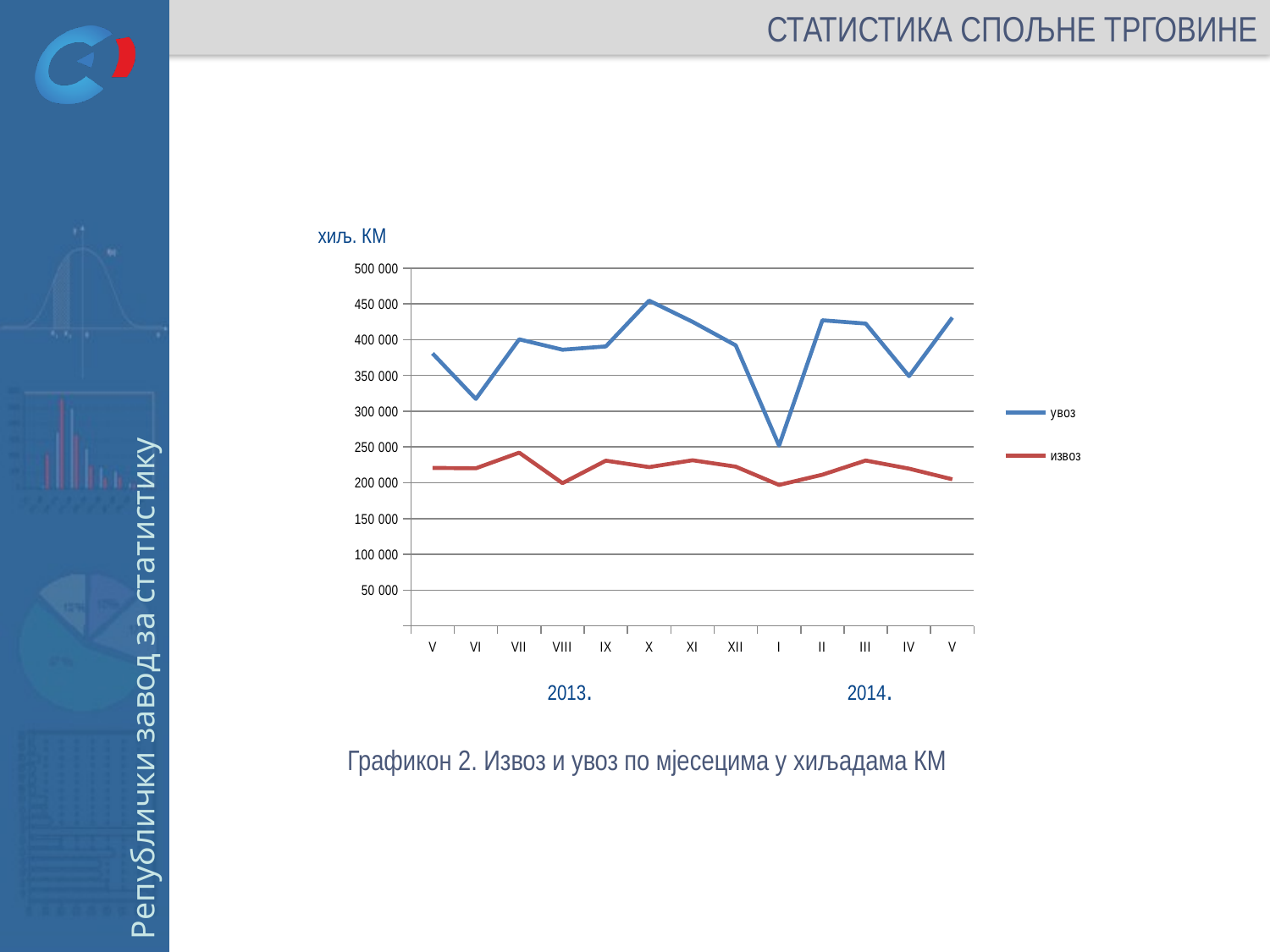
Is the value for увоз in X 2013 greater or less than 400 000? greater Which is larger for увоз, the value in V 2013 or the value in V 2014? V 2014 Is the value for извоз in VII 2013 greater or less than 250 000? less In which month is the value for увоз lowest? I 2014 Does the value for увоз rise or fall from XII 2013 to I 2014? fall How many series does the legend list? 2 What kind of chart is shown on the slide? line chart Which two series are listed in the legend? увоз and извоз Which is larger in III 2014, увоз or извоз? увоз In which month is the value for увоз highest? X 2013 Is the value for увоз in VI 2013 greater or less than 300 000? greater How many monthly points are plotted along the x axis? 13